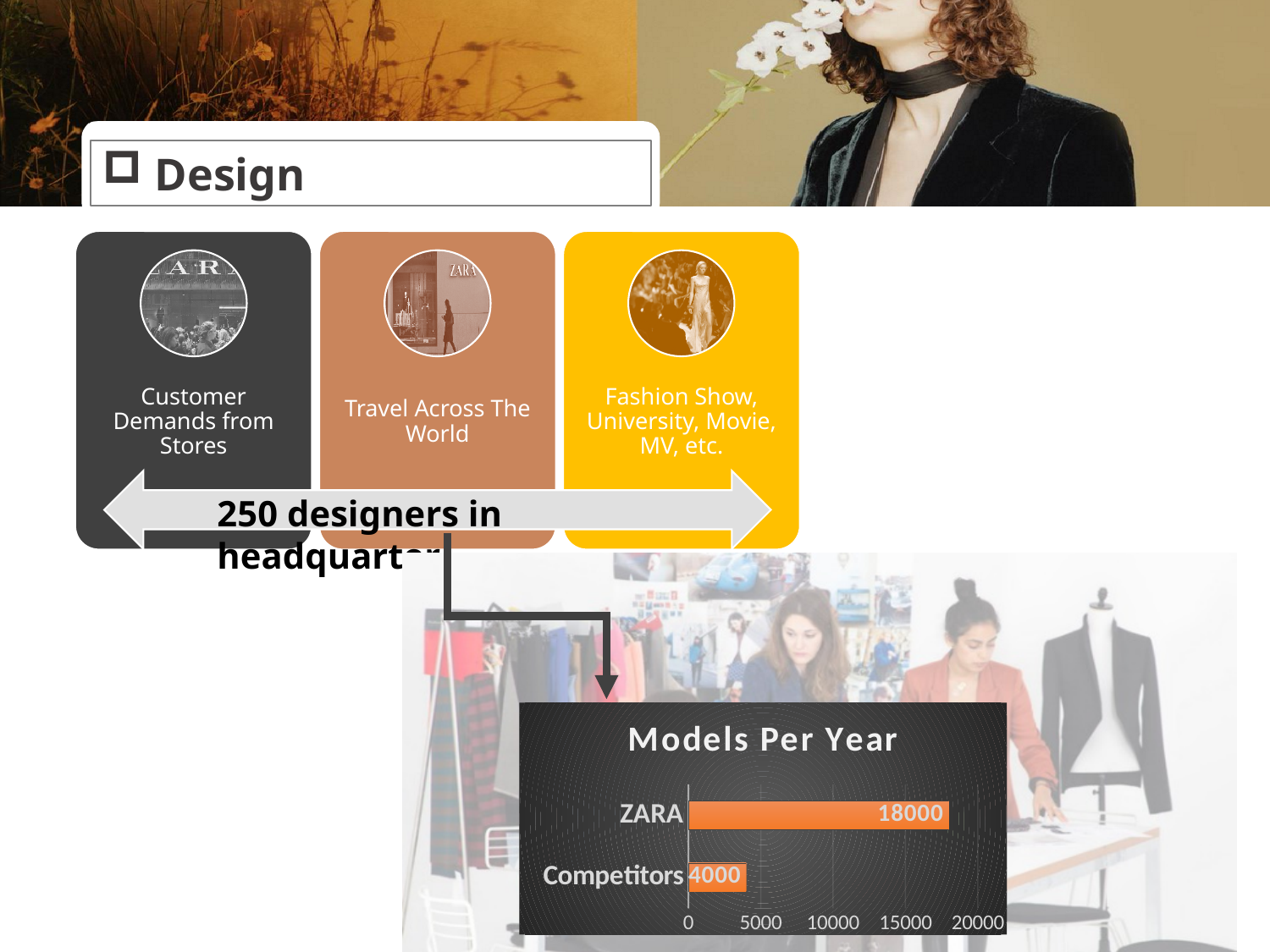
What is the difference between the ZARA and Competitors values in the Models Per Year chart? 14000 Is the value for ZARA in the Models Per Year chart greater or less than 15000? greater What is the title of the chart on the slide? Models Per Year How many categories does the Models Per Year chart show? 2 What is the maximum value shown on the horizontal axis of the Models Per Year chart? 20000 Which category has the lowest value in the Models Per Year chart? Competitors What is the value for ZARA in the Models Per Year chart? 18000 Which category has the highest value in the Models Per Year chart? ZARA Is the value for Competitors in the Models Per Year chart greater or less than 5000? less What type of chart is shown on the slide? bar chart Which is larger in the Models Per Year chart, ZARA or Competitors? ZARA What is the value for Competitors in the Models Per Year chart? 4000